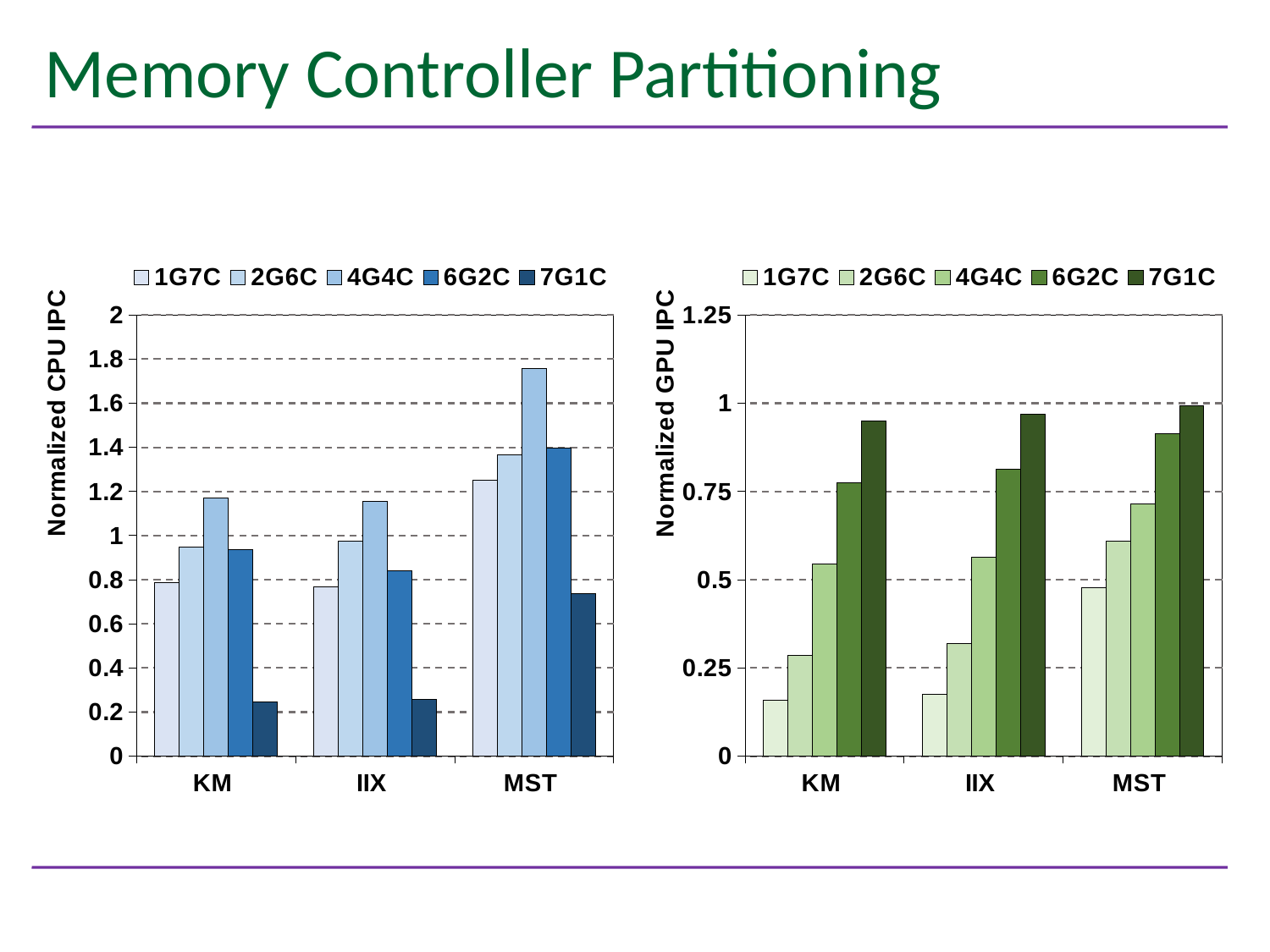
In the left chart (Normalized CPU IPC), is the value for 7G1C at KM greater or less than 0.4? less In the right chart (Normalized GPU IPC), which series has the highest value for IIX? 7G1C What kind of chart is the left chart (Normalized CPU IPC)? bar chart In the right chart (Normalized GPU IPC), do the values for KM rise or fall going from 1G7C to 7G1C? rise In the right chart (Normalized GPU IPC), is the value for 1G7C at MST greater or less than 0.25? greater In the right chart (Normalized GPU IPC), how many series does the legend list? 5 In the left chart (Normalized CPU IPC), how many categories are shown on the x axis? 3 In the left chart (Normalized CPU IPC), is the value for 4G4C at MST greater or less than 1.6? greater In the left chart (Normalized CPU IPC), which series has the lowest value for KM? 7G1C In the left chart (Normalized CPU IPC), which series has the highest value for MST? 4G4C In the right chart (Normalized GPU IPC), is the 4G4C value larger for MST or for KM? MST What is the y-axis title of the right chart? Normalized GPU IPC